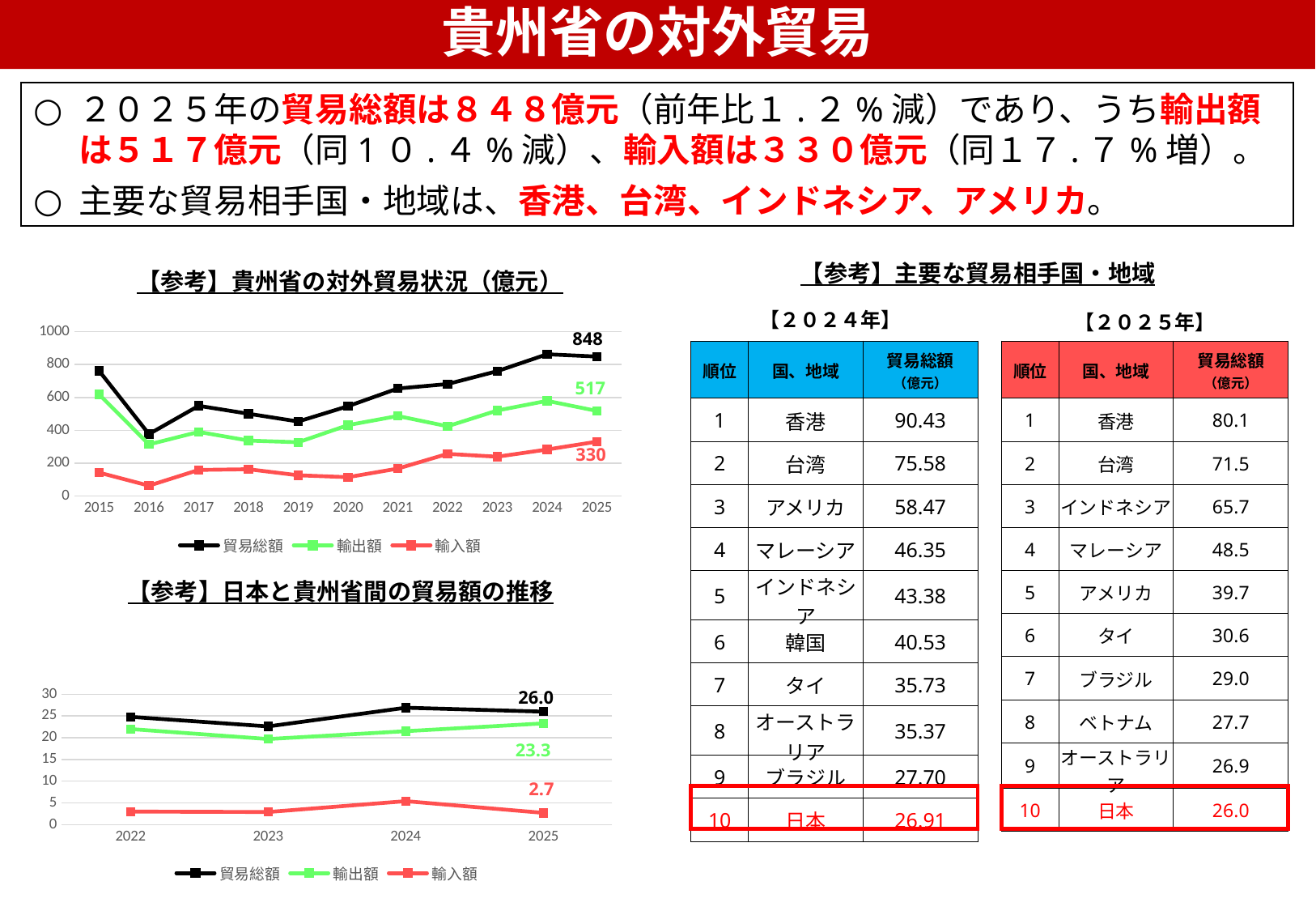
In the chart 【参考】貴州省の対外貿易状況（億元）, what is the value of 輸出額 in 2025? 517 In the chart 【参考】日本と貴州省間の貿易額の推移, what is the value of 輸入額 in 2025? 2.7 In the chart 【参考】貴州省の対外貿易状況（億元）, how many years are shown on the x axis? 11 In the chart 【参考】日本と貴州省間の貿易額の推移, what is the value of 貿易総額 in 2025? 26.0 In the chart 【参考】貴州省の対外貿易状況（億元）, what is the value of 貿易総額 in 2025? 848 In the chart 【参考】貴州省の対外貿易状況（億元）, in which year is 貿易総額 lowest? 2016 In the chart 【参考】日本と貴州省間の貿易額の推移, which is larger in 2025, 輸出額 or 輸入額? 輸出額 What kind of chart is 【参考】貴州省の対外貿易状況（億元）? line chart In the chart 【参考】貴州省の対外貿易状況（億元）, how many series does the legend list? 3 In the chart 【参考】貴州省の対外貿易状況（億元）, what is the value of 輸入額 in 2025? 330 In the chart 【参考】貴州省の対外貿易状況（億元）, what is the difference between 輸出額 and 輸入額 in 2025? 187 In the chart 【参考】貴州省の対外貿易状況（億元）, is the value of 貿易総額 in 2015 greater or less than 600? greater